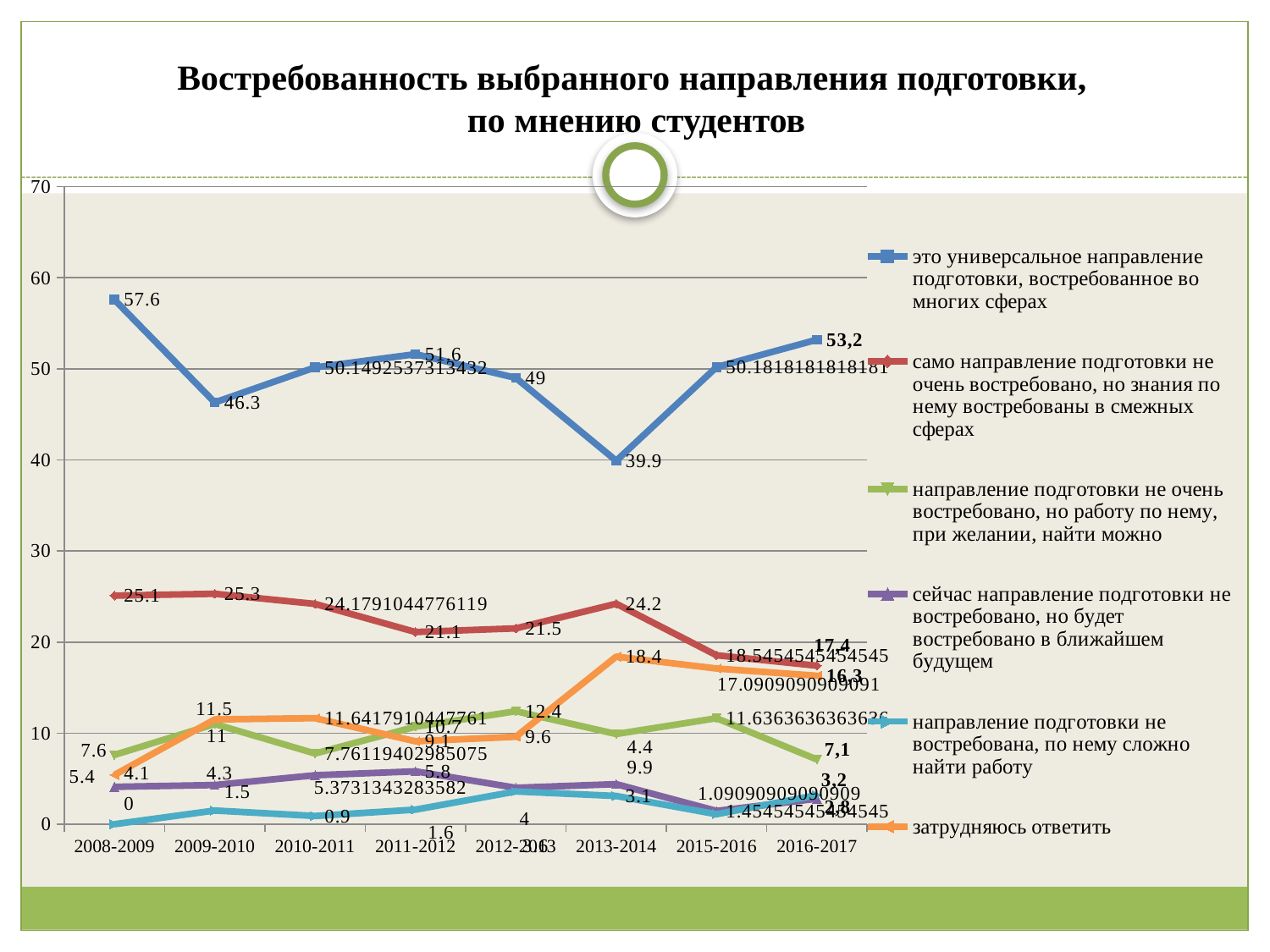
For the series 'это универсальное направление подготовки, востребованное во многих сферах', which year has the larger value: 2015-2016 or 2016-2017? 2016-2017 What is the value of the series 'это универсальное направление подготовки, востребованное во многих сферах' for 2008-2009? 57.6 In which year is the series 'это универсальное направление подготовки, востребованное во многих сферах' lowest? 2013-2014 Does the series 'это универсальное направление подготовки, востребованное во многих сферах' rise or fall from 2013-2014 to 2016-2017? rise How many series does the legend list? 6 In which year is the series 'это универсальное направление подготовки, востребованное во многих сферах' highest? 2008-2009 What is the value of the series 'затрудняюсь ответить' for 2013-2014? 18.4 What is the value of the series 'само направление подготовки не очень востребовано, но знания по нему востребованы в смежных сферах' for 2009-2010? 25.3 What type of chart is shown on the slide? line chart How many academic-year categories are shown on the x axis? 8 What is the difference between the 2008-2009 and 2009-2010 values of the series 'это универсальное направление подготовки, востребованное во многих сферах'? 11.3 What is the value of the series 'это универсальное направление подготовки, востребованное во многих сферах' for 2013-2014? 39.9